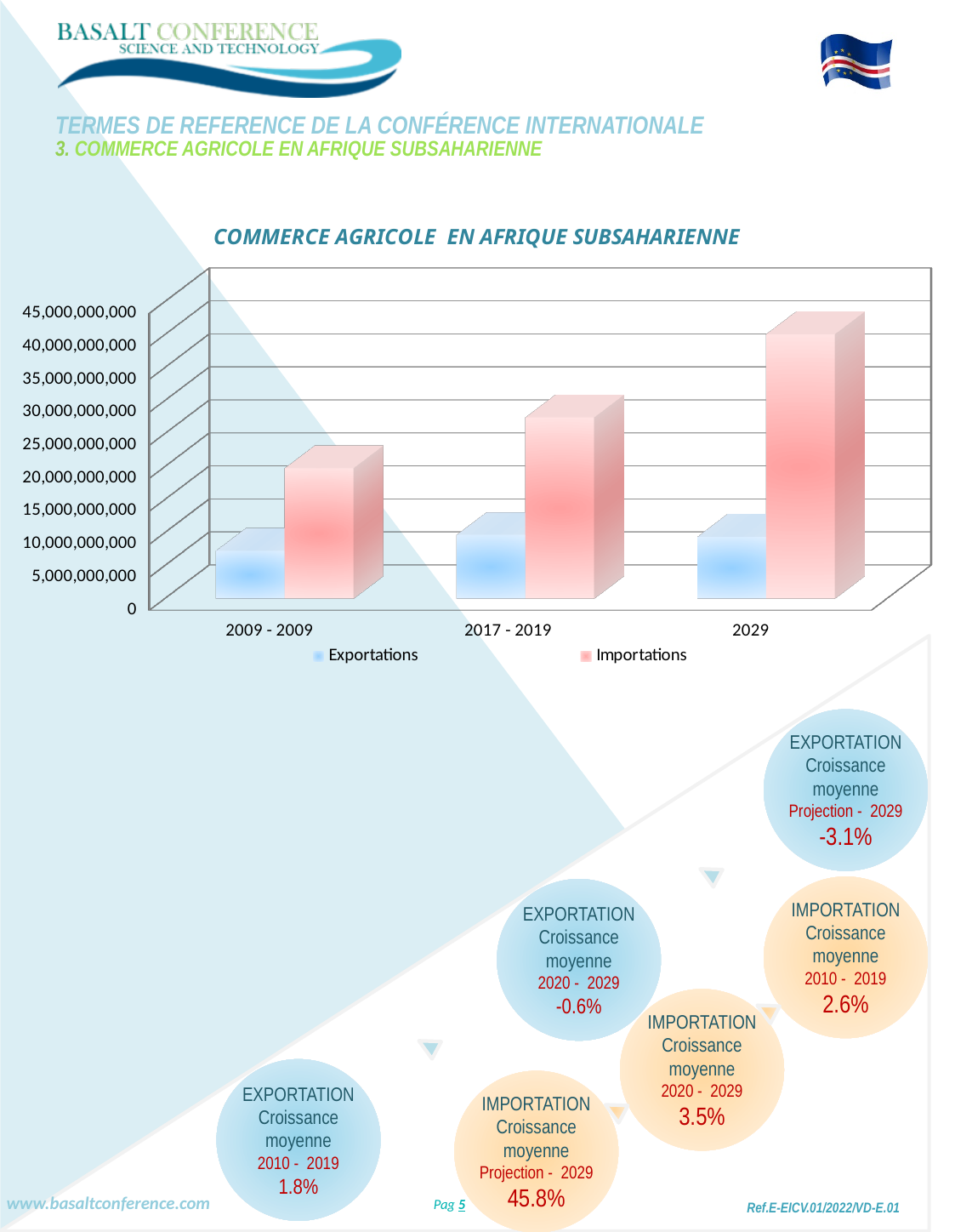
In which category is the Importations value highest? 2029 Is the Importations value for 2029 greater or less than 35,000,000,000? greater Which series is shown in red in the chart? Importations What kind of chart is shown on the slide? bar chart Is the Exportations value for 2009 - 2009 greater or less than 10,000,000,000? less In 2029, which is larger, Exportations or Importations? Importations In which category is the Importations value lowest? 2009 - 2009 How many categories are shown on the x axis of the chart? 3 Do the Importations values rise or fall from 2009 - 2009 to 2029? rise What is the title of the chart? COMMERCE AGRICOLE EN AFRIQUE SUBSAHARIENNE Is the Importations value for 2009 - 2009 greater or less than 25,000,000,000? less How many series does the chart legend list? 2